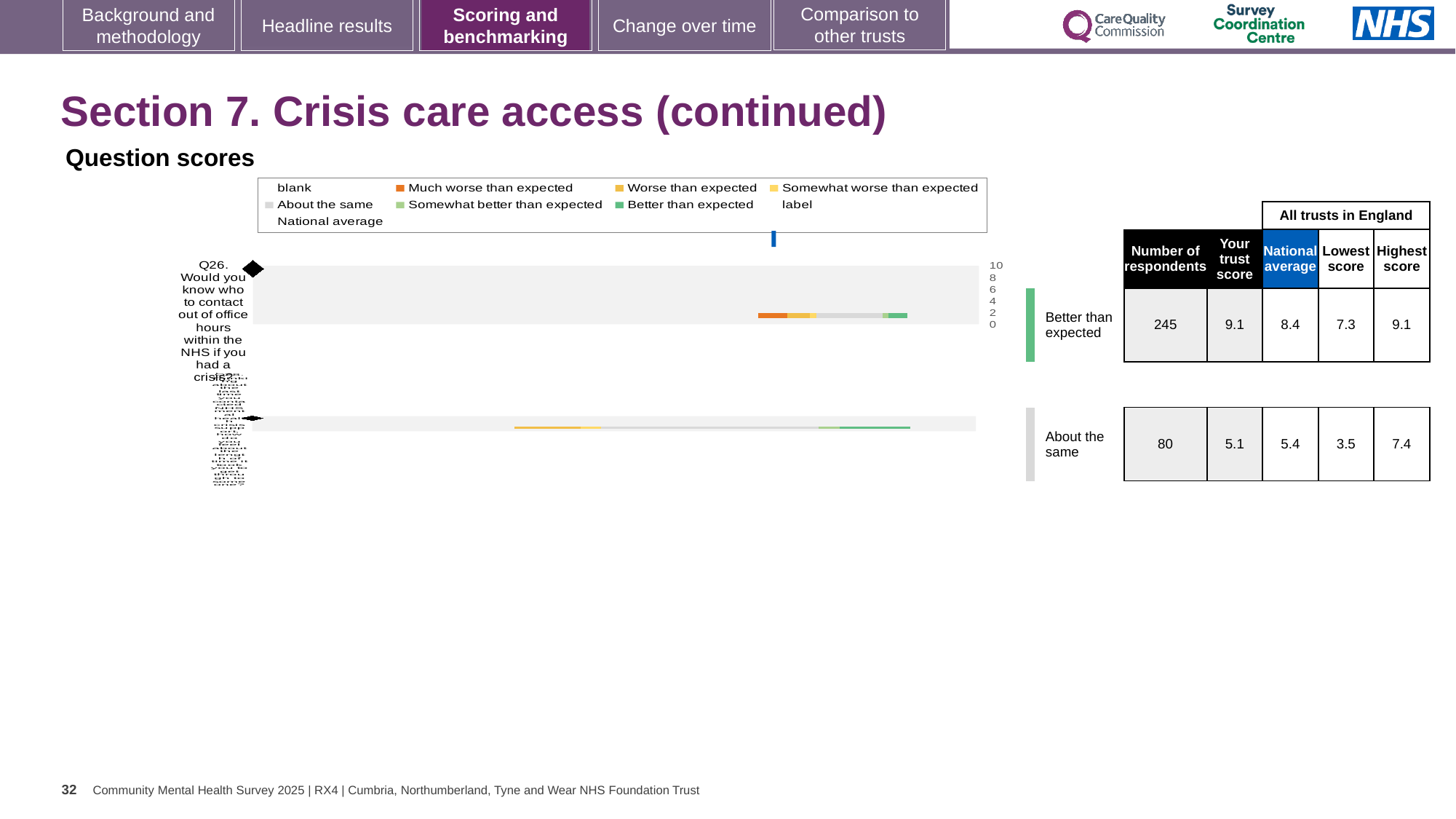
For the second question row (rated 'About the same'), which is larger: the trust score or the national average? the national average Which benchmark category is Q26 rated as? Better than expected What is the lowest score among all trusts in England for Q26? 7.3 What kind of chart is shown under 'Question scores'? bar chart How many question rows are plotted in the chart? 2 What is the trust score for the second question row, rated 'About the same'? 5.1 What is the national average score for Q26? 8.4 How many respondents answered Q26? 245 For Q26, what is the difference between the highest score and the lowest score among all trusts in England? 1.8 What is the highest score among all trusts in England for Q26? 9.1 What is the trust score for Q26 (Would you know who to contact out of office hours within the NHS if you had a crisis?)? 9.1 For Q26, which is larger: the trust score or the national average? the trust score